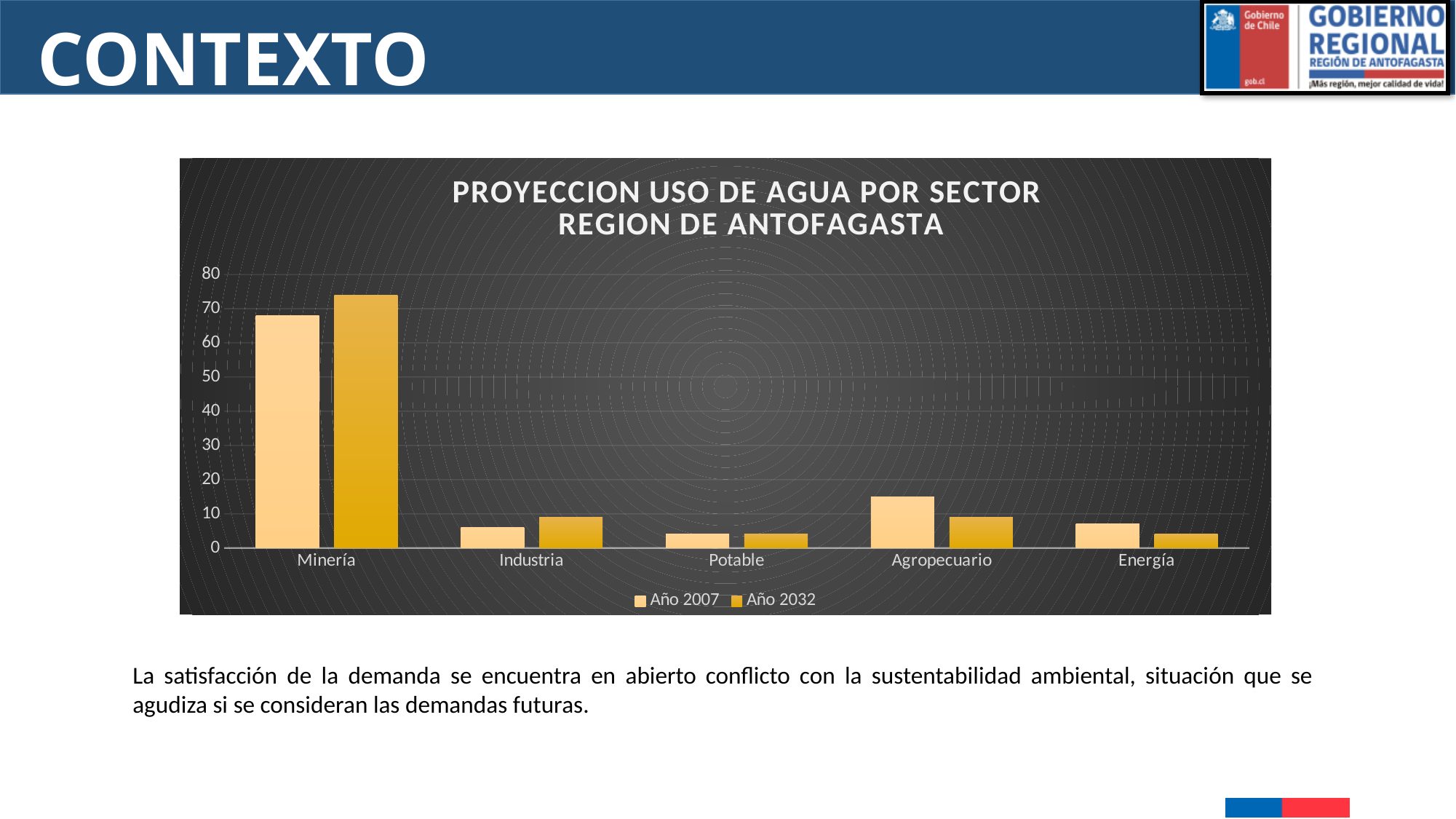
What is the title of the chart? PROYECCION USO DE AGUA POR SECTOR REGION DE ANTOFAGASTA What kind of chart is shown on the slide? bar chart Is the value for Minería in Año 2007 greater or less than 60? greater For Agropecuario, which series has the larger value, Año 2007 or Año 2032? Año 2007 Is the value for Agropecuario in Año 2007 greater or less than 10? greater Which sector has the highest value for Año 2007? Minería For Minería, which series has the larger value, Año 2007 or Año 2032? Año 2032 Is the value for Minería in Año 2032 greater or less than 70? greater Which sector has the highest value for Año 2032? Minería How many series does the chart's legend list? 2 How many sectors (categories) are shown on the x axis of the chart? 5